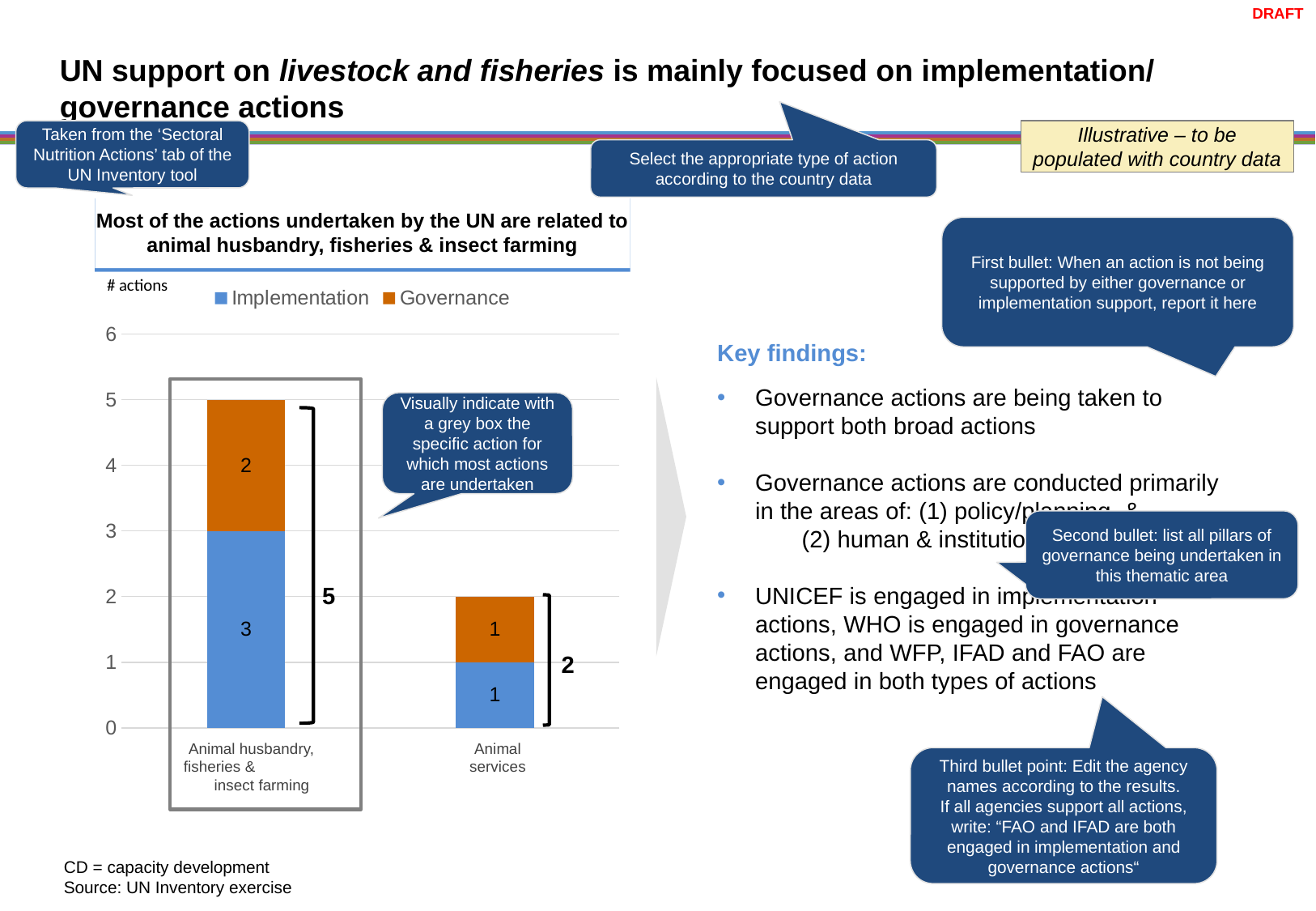
What kind of chart is shown on the slide? Stacked bar chart What is the Governance value for Animal services? 1 What is the Implementation value for Animal services? 1 What is the total number of actions for Animal services? 2 What is the difference between the Implementation values for Animal husbandry, fisheries & insect farming and Animal services? 2 What is the total number of actions for Animal husbandry, fisheries & insect farming? 5 What is the Governance value for Animal husbandry, fisheries & insect farming? 2 Which category has the highest total number of actions? Animal husbandry, fisheries & insect farming How many series does the chart legend list? 2 What is the Implementation value for Animal husbandry, fisheries & insect farming? 3 How many categories are shown on the x axis of the chart? 2 Which series is shown in orange in the chart legend? Governance